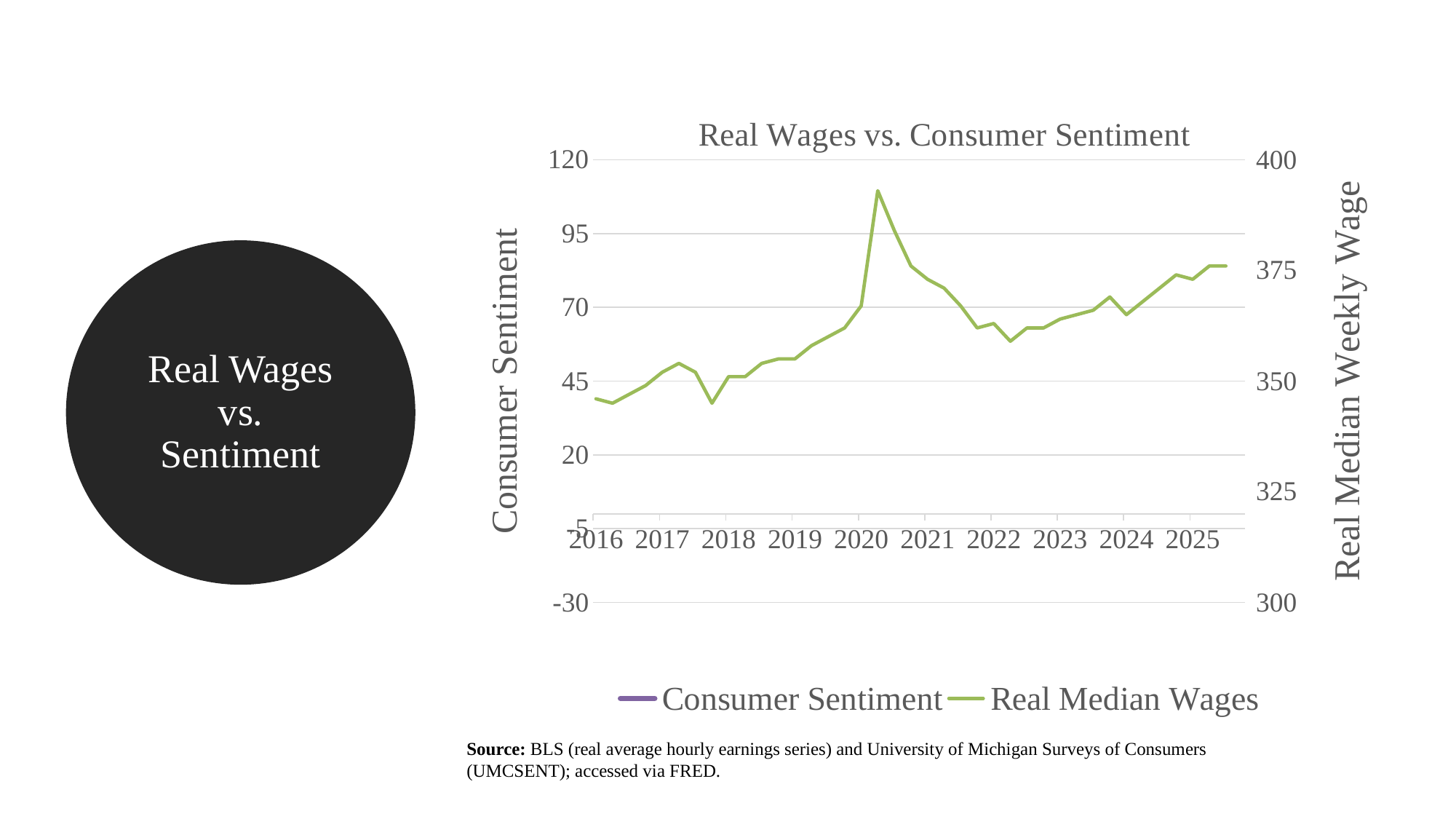
Is the Real Median Wages value at its 2022 low point greater or less than 375 on the right axis? less Is the Real Median Wages value at the start of 2019 greater or less than 350 on the right axis? greater In which year does the Real Median Wages line reach its highest point? 2020 What type of chart is shown on the slide? line chart What is the first year shown on the x axis? 2016 What is the title of the chart? Real Wages vs. Consumer Sentiment Is the Real Median Wages value in 2020 larger than the value in 2016? yes How many series does the chart's legend list? 2 Is the peak value of the Real Median Wages line in 2020 greater or less than 375 on the right axis? greater What is the label of the right-hand vertical axis? Real Median Weekly Wage Overall, does the Real Median Wages line rise or fall from 2016 to 2025? rise